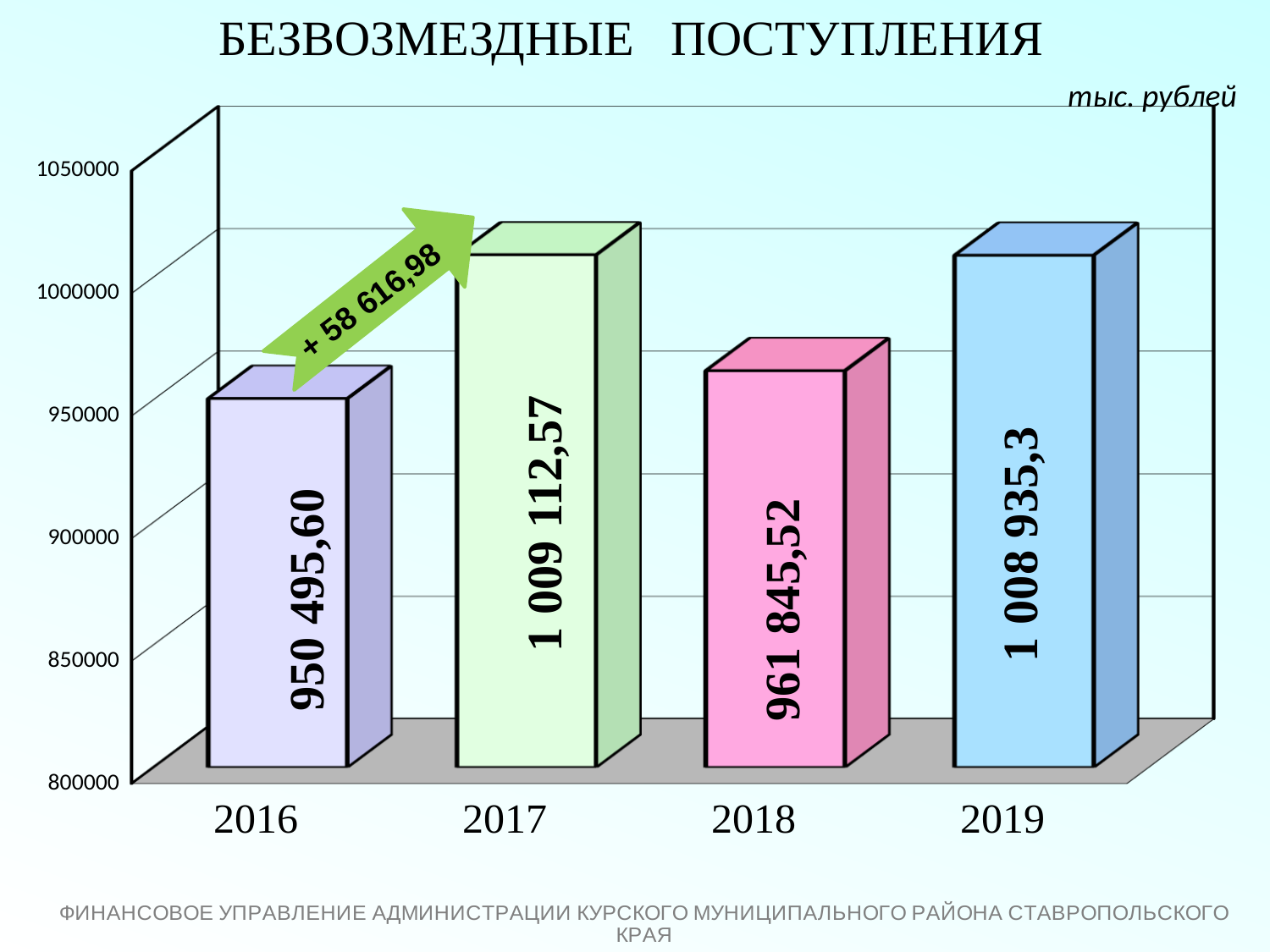
What is the value for 2017? 1 009 112,57 How many years are shown on the chart? 4 Which year has the highest value? 2017 What is the value for 2018? 961 845,52 What is the value for 2016? 950 495,60 What is the value for 2019? 1 008 935,3 What unit is indicated for the values on the chart? тыс. рублей What kind of chart is shown on the slide? bar chart Is the value for 2018 greater or less than 1000000? less What is the difference between the values for 2018 and 2016? 11 349,92 Which year has the lowest value? 2016 Which is larger, the value for 2018 or the value for 2019? 2019